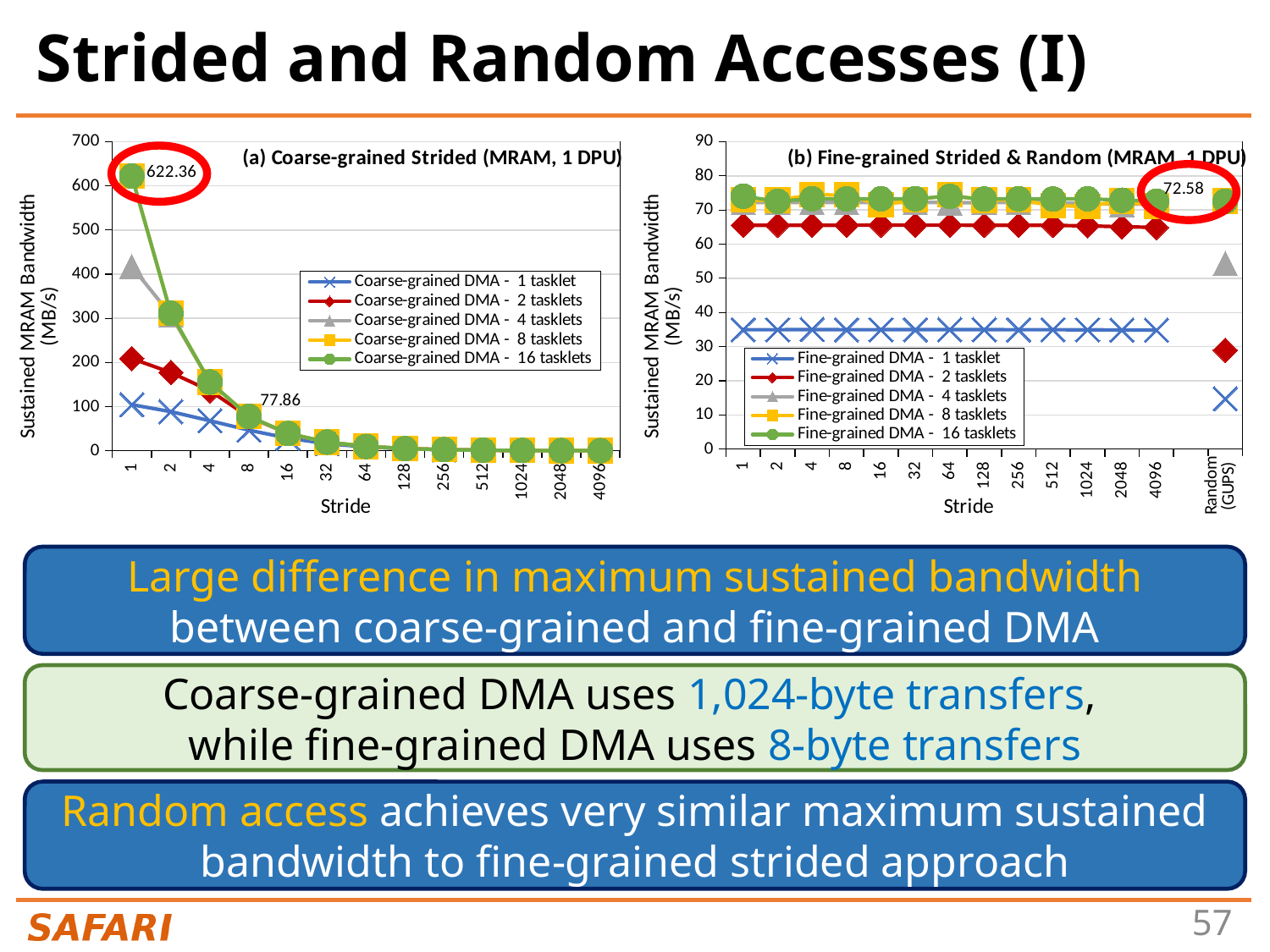
In chart (b) Fine-grained Strided & Random (MRAM, 1 DPU), what value is labeled for Random (GUPS)? 72.58 How many stride values are shown on the x axis of chart (a) Coarse-grained Strided (MRAM, 1 DPU)? 13 What is the y-axis label of chart (a) Coarse-grained Strided (MRAM, 1 DPU)? Sustained MRAM Bandwidth (MB/s) How many categories are shown on the x axis of chart (b) Fine-grained Strided & Random (MRAM, 1 DPU), including Random (GUPS)? 14 In chart (b) Fine-grained Strided & Random (MRAM, 1 DPU), is the value for Fine-grained DMA - 2 tasklets at stride 1 greater or less than 60? greater In chart (a) Coarse-grained Strided (MRAM, 1 DPU), does the Coarse-grained DMA - 16 tasklets series rise or fall as stride increases? fall In chart (b) Fine-grained Strided & Random (MRAM, 1 DPU), which is larger at Random (GUPS): Fine-grained DMA - 16 tasklets or Fine-grained DMA - 1 tasklet? Fine-grained DMA - 16 tasklets What kind of chart is chart (a) Coarse-grained Strided (MRAM, 1 DPU)? line chart How many series does the legend of chart (b) Fine-grained Strided & Random (MRAM, 1 DPU) list? 5 In chart (a) Coarse-grained Strided (MRAM, 1 DPU), what value is labeled at stride 1? 622.36 In chart (a) Coarse-grained Strided (MRAM, 1 DPU), what is the second data label shown, near stride 8? 77.86 In chart (b) Fine-grained Strided & Random (MRAM, 1 DPU), is the value for Fine-grained DMA - 1 tasklet at stride 1 greater or less than 40? less